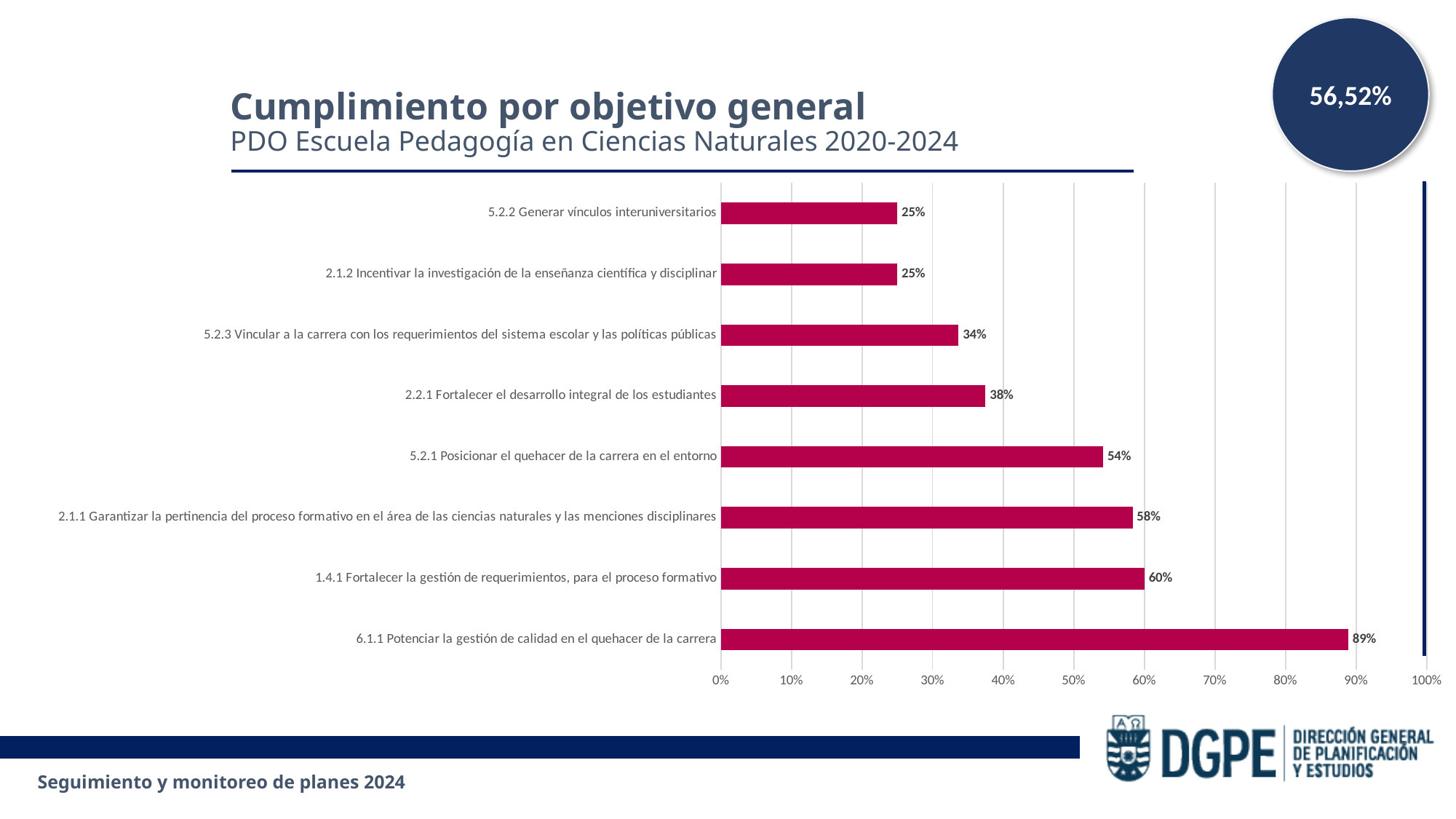
What is the value for 2.2.1 Fortalecer el desarrollo integral de los estudiantes? 38% What is the difference between the values for 1.4.1 Fortalecer la gestión de requerimientos, para el proceso formativo and 5.2.1 Posicionar el quehacer de la carrera en el entorno? 6% What is the title of the chart? Cumplimiento por objetivo general What is the value for 1.4.1 Fortalecer la gestión de requerimientos, para el proceso formativo? 60% How many objectives are shown on the chart? 8 What is the lowest value shown on the chart? 25% Is the value for 2.1.1 Garantizar la pertinencia del proceso formativo en el área de las ciencias naturales y las menciones disciplinares greater or less than 50%? greater What kind of chart is shown on the slide? Bar chart Which objective has the highest value? 6.1.1 Potenciar la gestión de calidad en el quehacer de la carrera What is the value for 6.1.1 Potenciar la gestión de calidad en el quehacer de la carrera? 89% Which is larger: the value for 5.2.3 Vincular a la carrera con los requerimientos del sistema escolar y las políticas públicas or the value for 2.2.1 Fortalecer el desarrollo integral de los estudiantes? 2.2.1 Fortalecer el desarrollo integral de los estudiantes What is the difference between the values for 6.1.1 Potenciar la gestión de calidad en el quehacer de la carrera and 5.2.2 Generar vínculos interuniversitarios? 64%